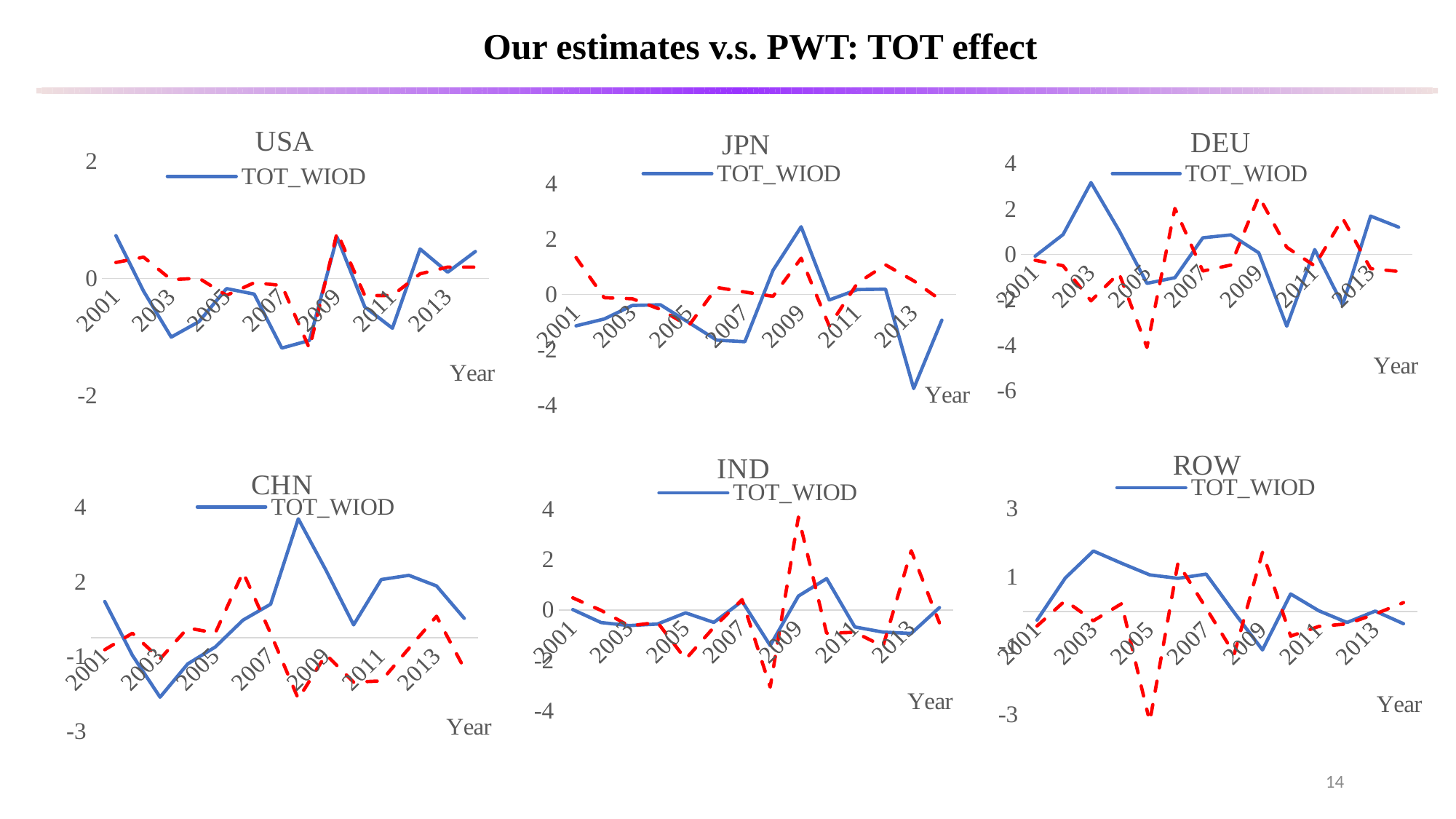
How many country/region charts are shown on the slide? 6 In the JPN chart, in which year does the solid blue TOT_WIOD line reach its lowest value? 2013 In the ROW chart, which is larger for the solid blue TOT_WIOD line: the value in 2003 or the value in 2009? 2003 In the CHN chart, is the solid blue TOT_WIOD value for 2003 greater or less than -1? less What series name appears in the legend of each chart? TOT_WIOD In the JPN chart, is the solid blue TOT_WIOD value for 2013 greater or less than -2? less In the DEU chart, is the solid blue TOT_WIOD value for 2003 greater or less than 2? greater In the CHN chart, in which year does the solid blue TOT_WIOD line peak? 2008 In the JPN chart, in which year does the solid blue TOT_WIOD line reach its highest value? 2009 In the DEU chart, in which year does the solid blue TOT_WIOD line reach its highest value? 2003 What kind of chart is used in each of the six panels on the slide? Line chart